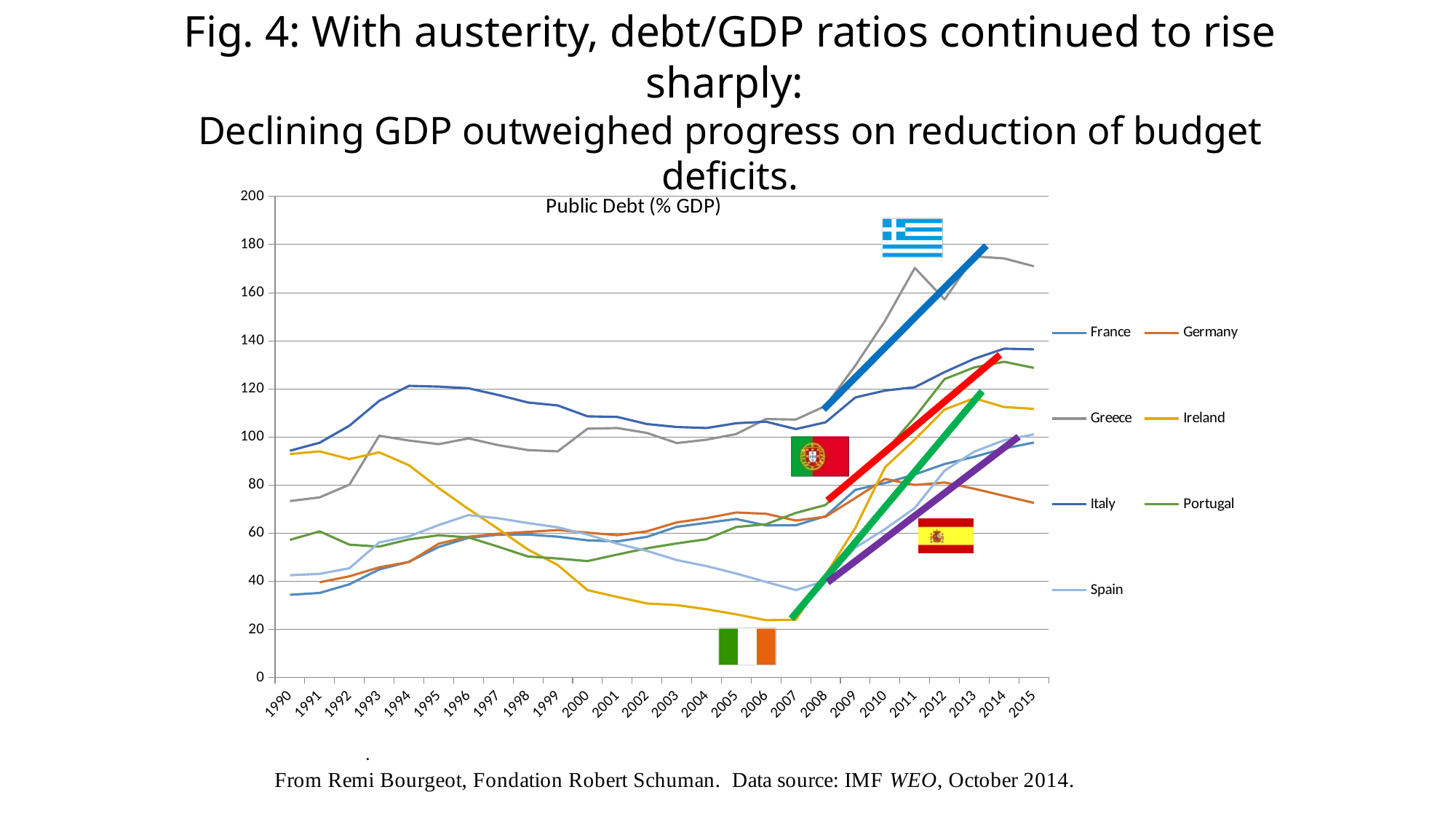
Is the value for Ireland in 2007 greater or less than 40? less In 2015, which is larger: the value for Italy or the value for Germany? Italy What is the title of the chart? Public Debt (% GDP) Does the value for Greece rise or fall between 2008 and 2011? rise How many years are shown along the x axis of the chart? 26 Which country has the lowest public debt (% GDP) in 2007? Ireland Does the value for Ireland rise or fall between 1993 and 2007? fall Which country has the highest public debt (% GDP) in 2015? Greece What kind of chart is shown on the slide? line chart How many series does the legend of the Public Debt (% GDP) chart list? 7 Is the value for Germany in 2015 greater or less than 80? less Is the value for Greece in 2011 greater or less than 140? greater